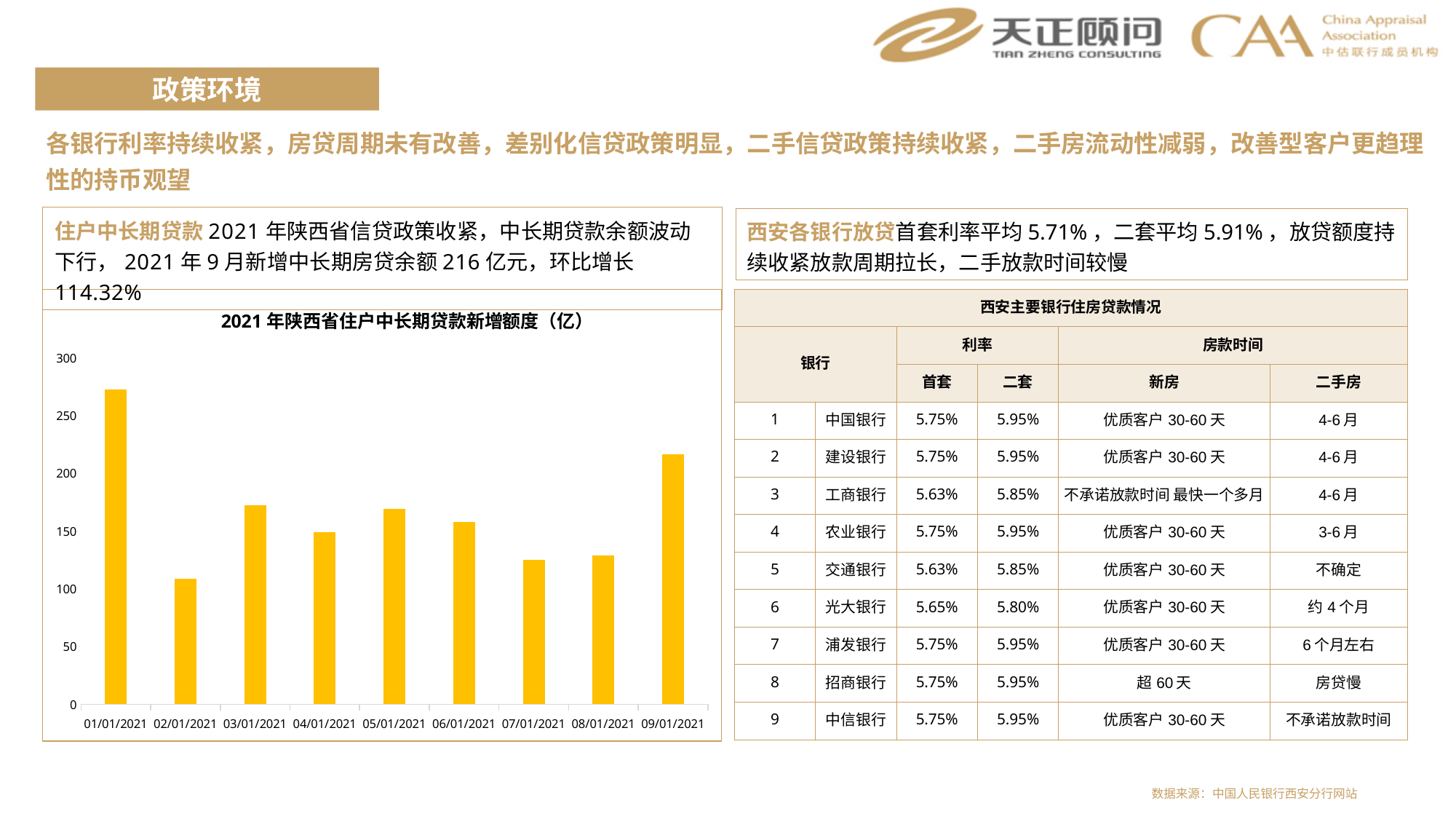
Is the value for 09/01/2021 greater or less than 200? greater How many months (bars) are plotted in the chart? 9 Which month has the lowest value in the chart? 02/01/2021 Which month has the highest value in the chart? 01/01/2021 Is the value for 07/01/2021 greater or less than 150? less Is the value for 01/01/2021 greater or less than 250? greater What is the title of the chart? 2021年陕西省住户中长期贷款新增额度（亿） Which is larger, the value for 03/01/2021 or the value for 07/01/2021? 03/01/2021 Does the value rise or fall from 08/01/2021 to 09/01/2021? rise What kind of chart is shown on the slide? bar chart Which is larger, the value for 01/01/2021 or the value for 09/01/2021? 01/01/2021